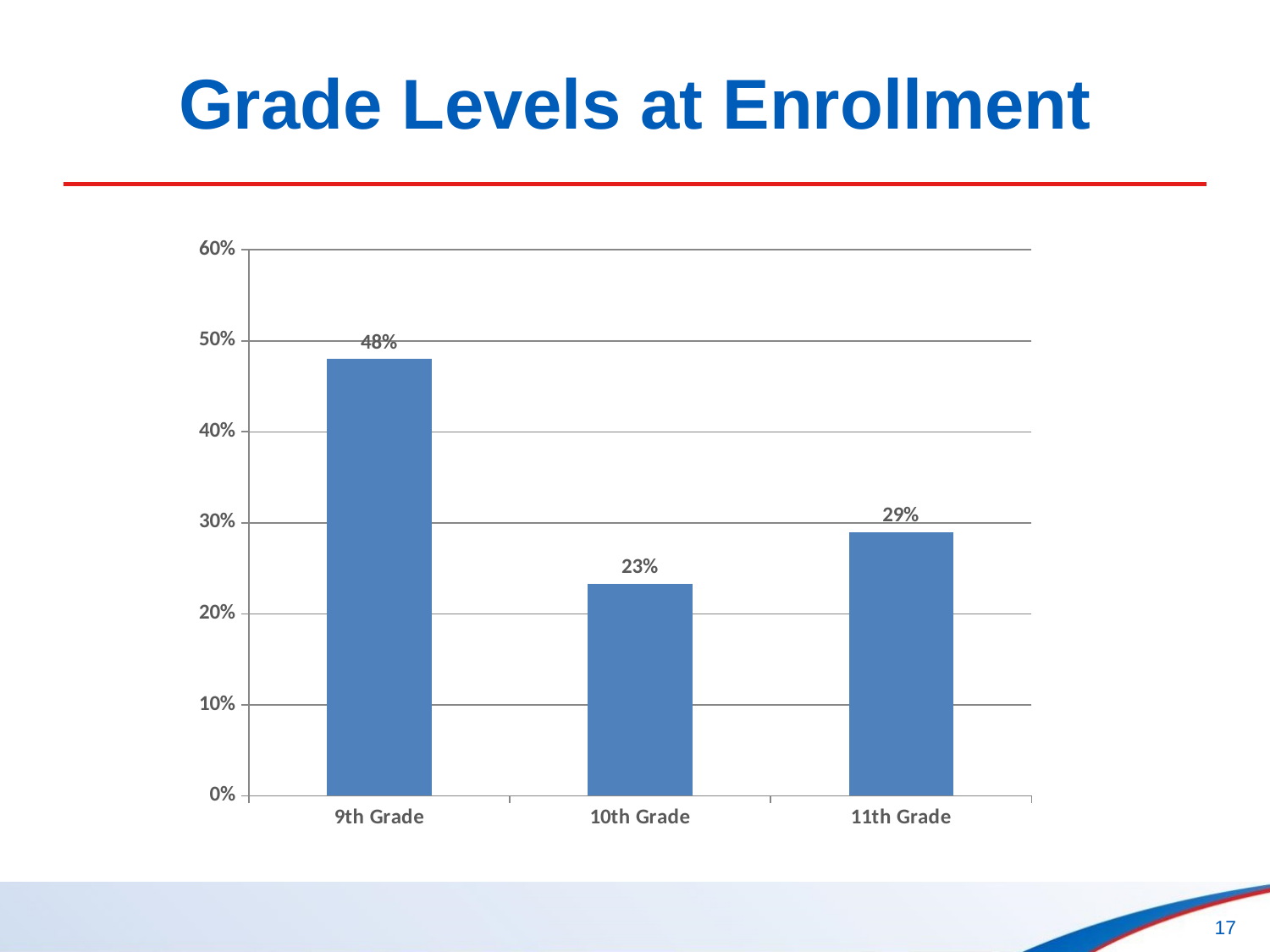
Is the value for 9th Grade greater or less than 40%? greater Which has a larger enrollment percentage, 10th Grade or 11th Grade? 11th Grade What kind of chart is shown on the slide? Bar chart Which grade level has the highest enrollment percentage? 9th Grade What percentage of students enrolled in 11th Grade? 29% What is the title of the slide? Grade Levels at Enrollment What is the difference in percentage points between 11th Grade and 10th Grade enrollment? 6 How many grade levels are shown on the chart? 3 What is the difference in percentage points between 9th Grade and 10th Grade enrollment? 25 What percentage of students enrolled in 9th Grade? 48% What percentage of students enrolled in 10th Grade? 23% Which grade level has the lowest enrollment percentage? 10th Grade